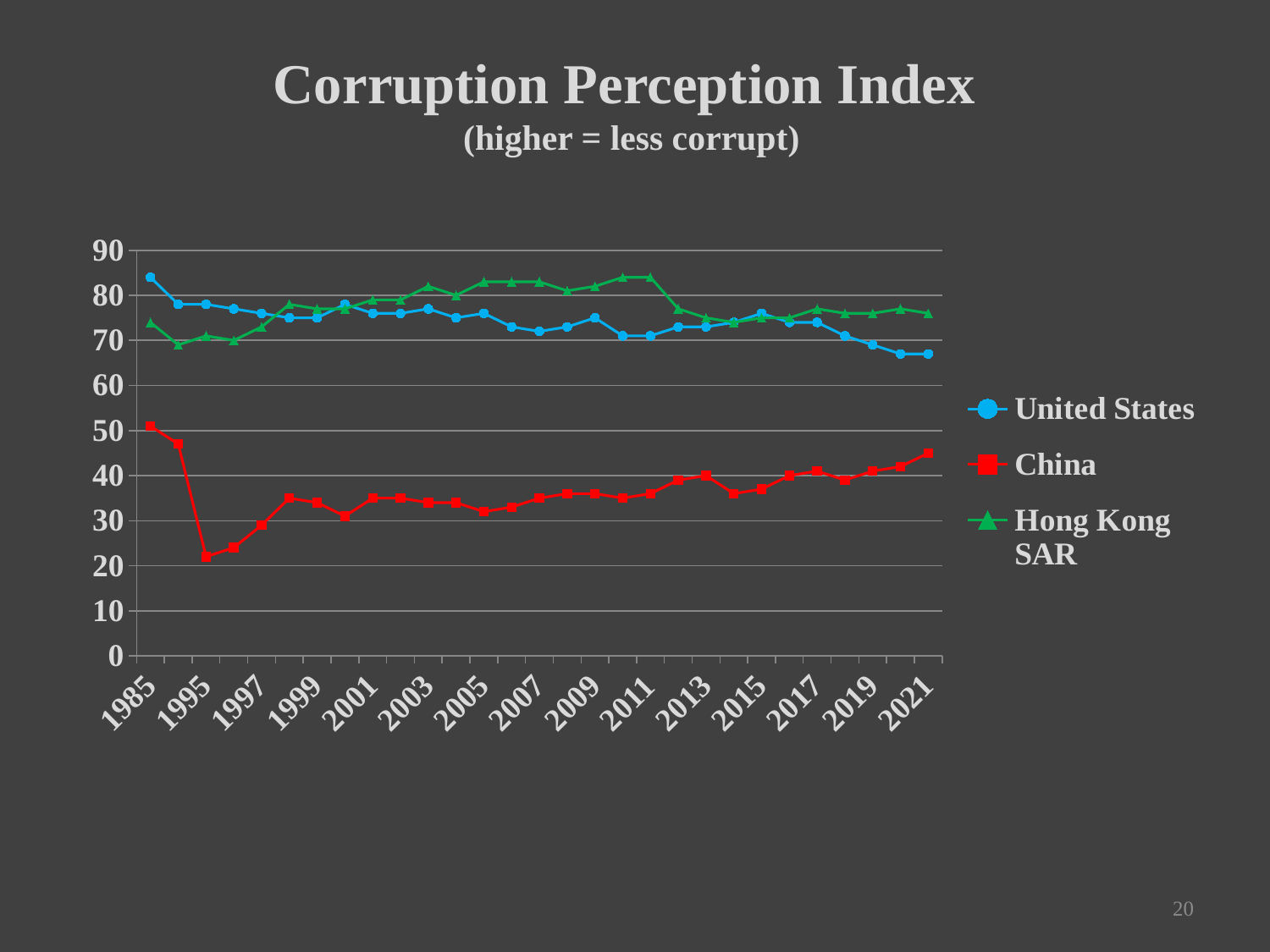
What kind of chart is shown on the slide? line chart How many series does the legend list? 3 Is the value for the United States in 1985 greater or less than 80? greater In 2011, which is larger: the value for Hong Kong SAR or the value for the United States? Hong Kong SAR Which series is plotted with red square markers? China What is the subtitle shown under the chart title? (higher = less corrupt) In 1985, which is larger: the value for the United States or the value for Hong Kong SAR? United States Which series has the lowest values across the whole period? China Is the value for the United States in 2021 greater or less than 70? less Does the value for the United States rise or fall from 2015 to 2021? fall Is the value for China in 2021 greater or less than 50? less